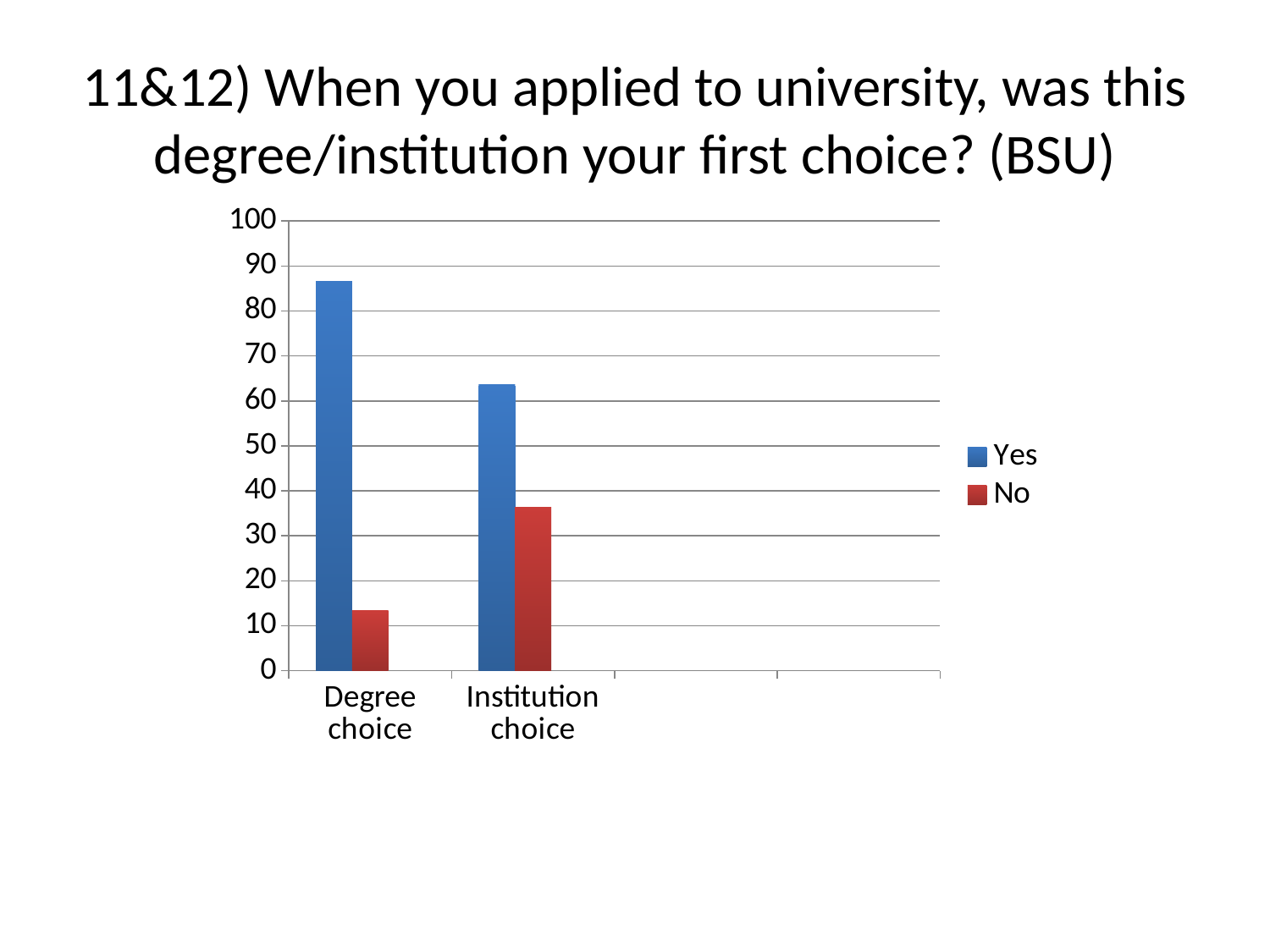
What kind of chart is shown on the slide? bar chart Is the Yes value for Institution choice greater or less than 60? greater What colour represents the No series in the chart? red Which bar is the tallest in the chart? Yes for Degree choice Which category has the higher Yes value, Degree choice or Institution choice? Degree choice How many series does the legend list? 2 Is the No value for Degree choice greater or less than 20? less Which category has the higher No value, Degree choice or Institution choice? Institution choice Is the Yes value for Degree choice greater or less than 80? greater Which bar is the shortest in the chart? No for Degree choice How many categories are shown on the x axis? 2